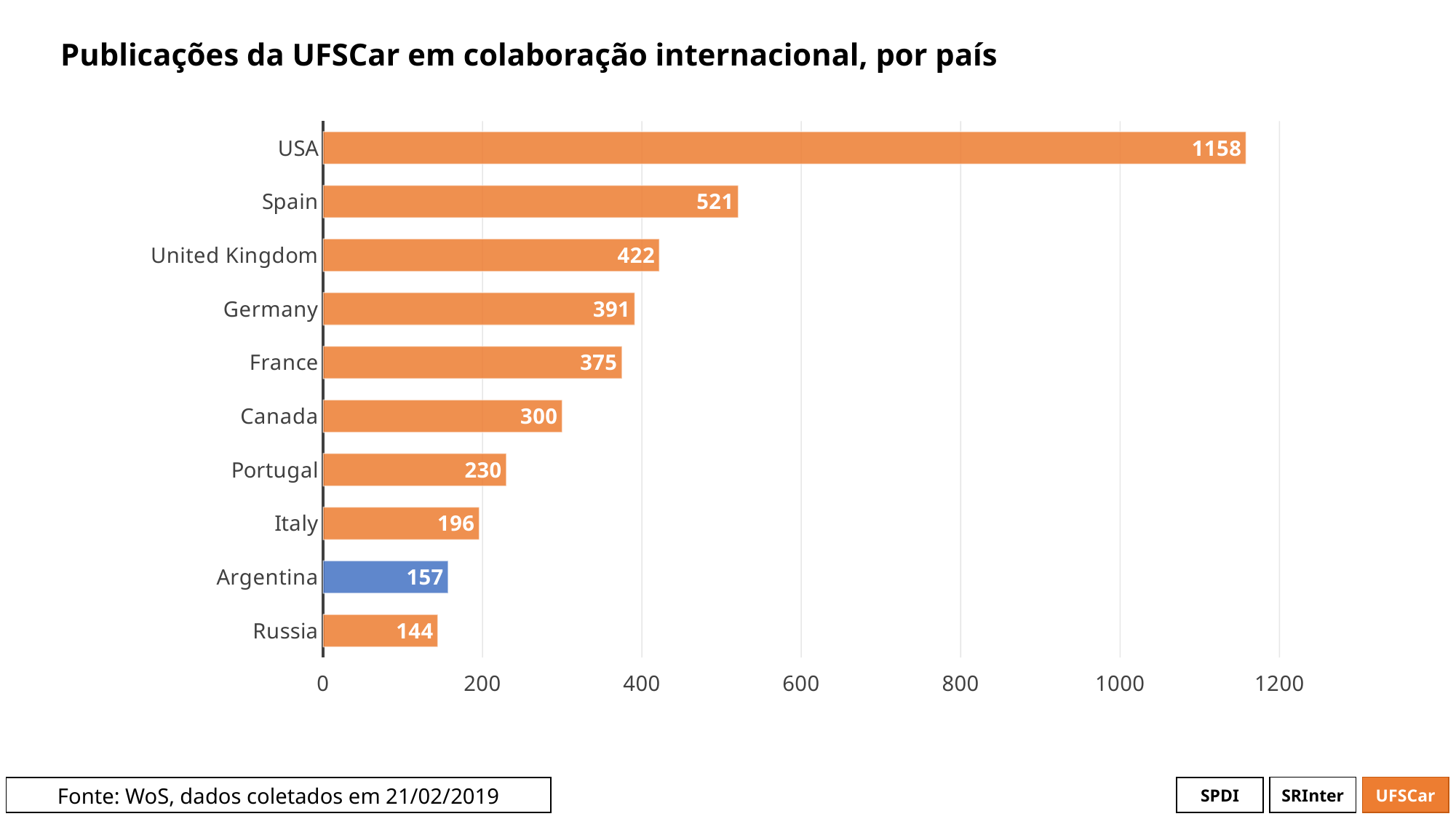
How many countries are shown in the chart? 10 What is the value for Argentina? 157 What is the difference between the values for Canada and Portugal? 70 Which country has the highest value? USA Which country's bar is coloured blue instead of orange? Argentina What is the value for USA? 1158 What kind of chart is shown on the slide? bar chart Which country has the lowest value? Russia Is the value for Italy greater or less than 200? less What is the difference between the values for Spain and United Kingdom? 99 Which is larger, the value for France or the value for Canada? France What is the value for Germany? 391